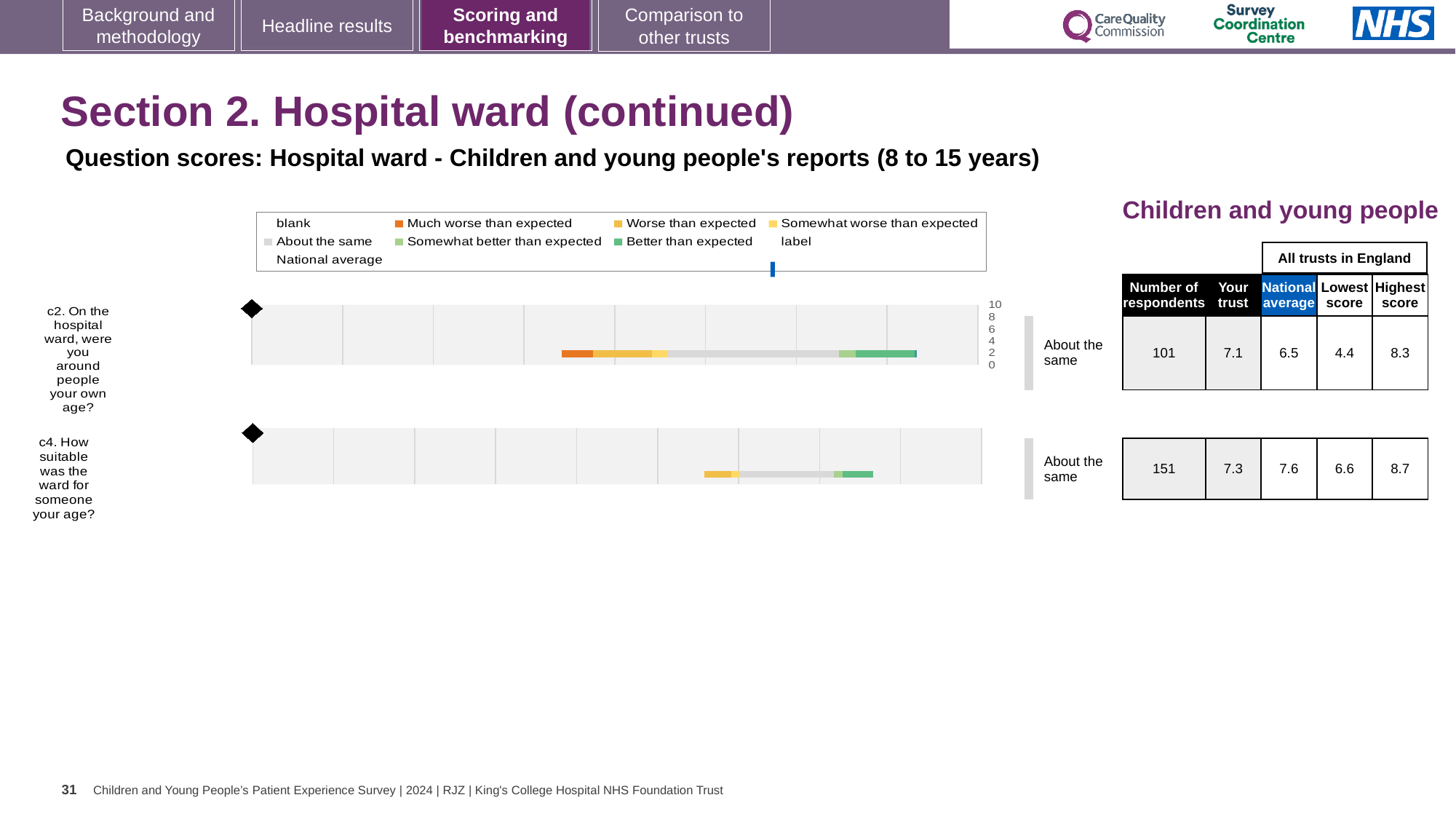
How many respondents answered question c4? 151 What is the national average score for question c4? 7.6 What is the highest score among all trusts in England for question c2? 8.3 What is the lowest score among all trusts in England for question c4? 6.6 How many questions are plotted on this slide? 2 How is the trust's result for question c2 categorised relative to expectations? About the same What is the 'Your trust' score for question c2 (On the hospital ward, were you around people your own age?)? 7.1 What type of chart is used to show the question scores? Bar chart What is the 'Your trust' score for question c4 (How suitable was the ward for someone your age?)? 7.3 What is the difference between the highest and lowest scores for question c2? 3.9 What is the national average score for question c2? 6.5 Which question has the higher 'Your trust' score, c2 or c4? c4